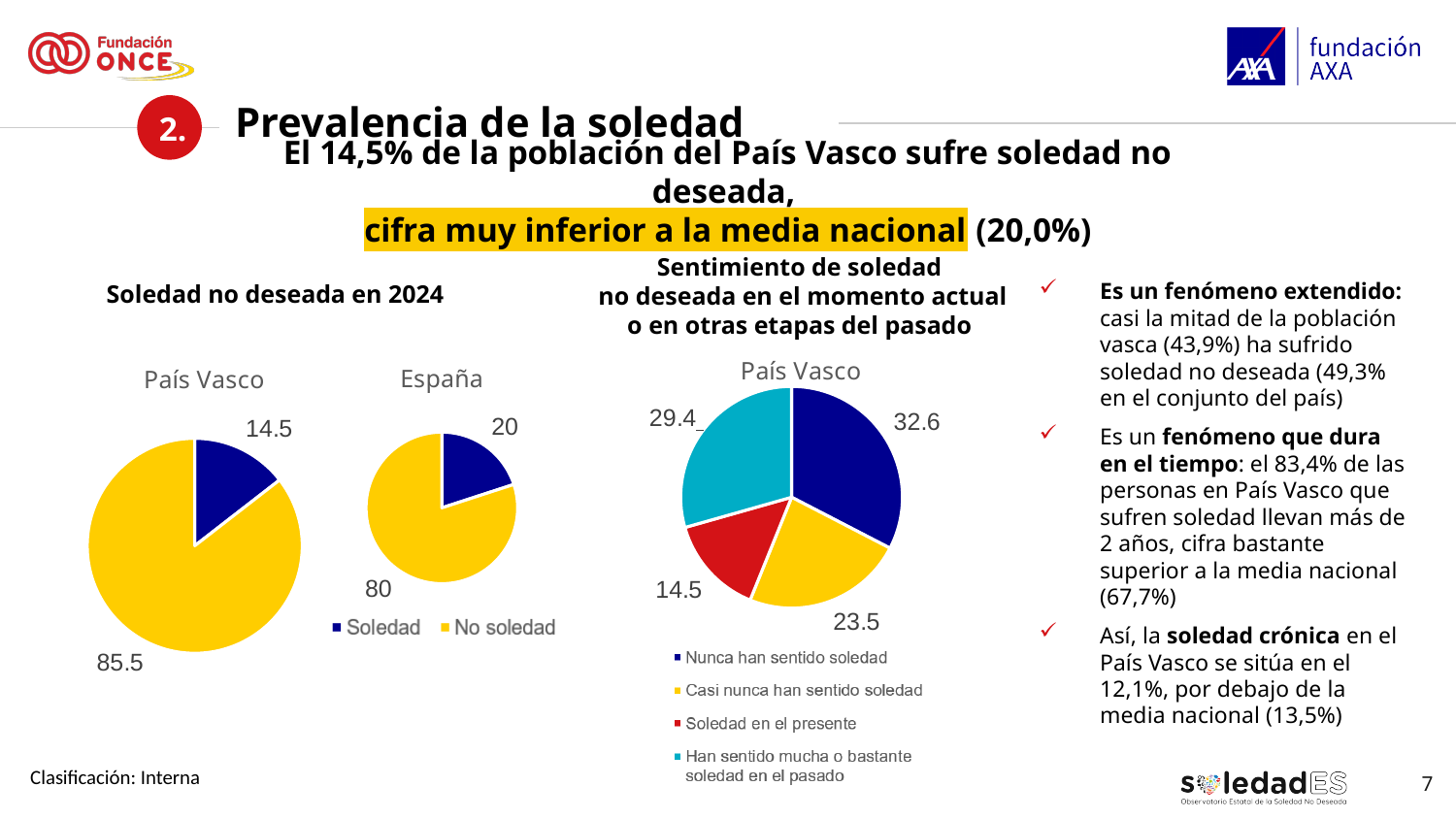
In the 'Sentimiento de soledad no deseada' pie chart for País Vasco, what is the value for 'Han sentido mucha o bastante soledad en el pasado'? 29.4 Comparing the 'Soledad' slices in the 'Soledad no deseada en 2024' charts, which is larger: País Vasco or España? España In the 'Soledad no deseada en 2024' pie chart for País Vasco, what is the value for 'No soledad'? 85.5 In the 'Soledad no deseada en 2024' pie chart for España, what is the value for 'No soledad'? 80 What kind of chart is used for 'Sentimiento de soledad no deseada en el momento actual o en otras etapas del pasado'? Pie chart In the 'Sentimiento de soledad no deseada' pie chart for País Vasco, what is the value for 'Nunca han sentido soledad'? 32.6 In the 'Sentimiento de soledad no deseada' pie chart for País Vasco, which category has the smallest slice? Soledad en el presente In the 'Soledad no deseada en 2024' charts, what is the difference between the 'Soledad' value for España and the 'Soledad' value for País Vasco? 5.5 How many series does the legend of the 'Soledad no deseada en 2024' charts list? 2 In the 'Sentimiento de soledad no deseada' pie chart for País Vasco, which category has the largest slice? Nunca han sentido soledad How many slices does the 'Sentimiento de soledad no deseada' pie chart for País Vasco have? 4 In the 'Soledad no deseada en 2024' pie chart for País Vasco, what is the value for 'Soledad'? 14.5